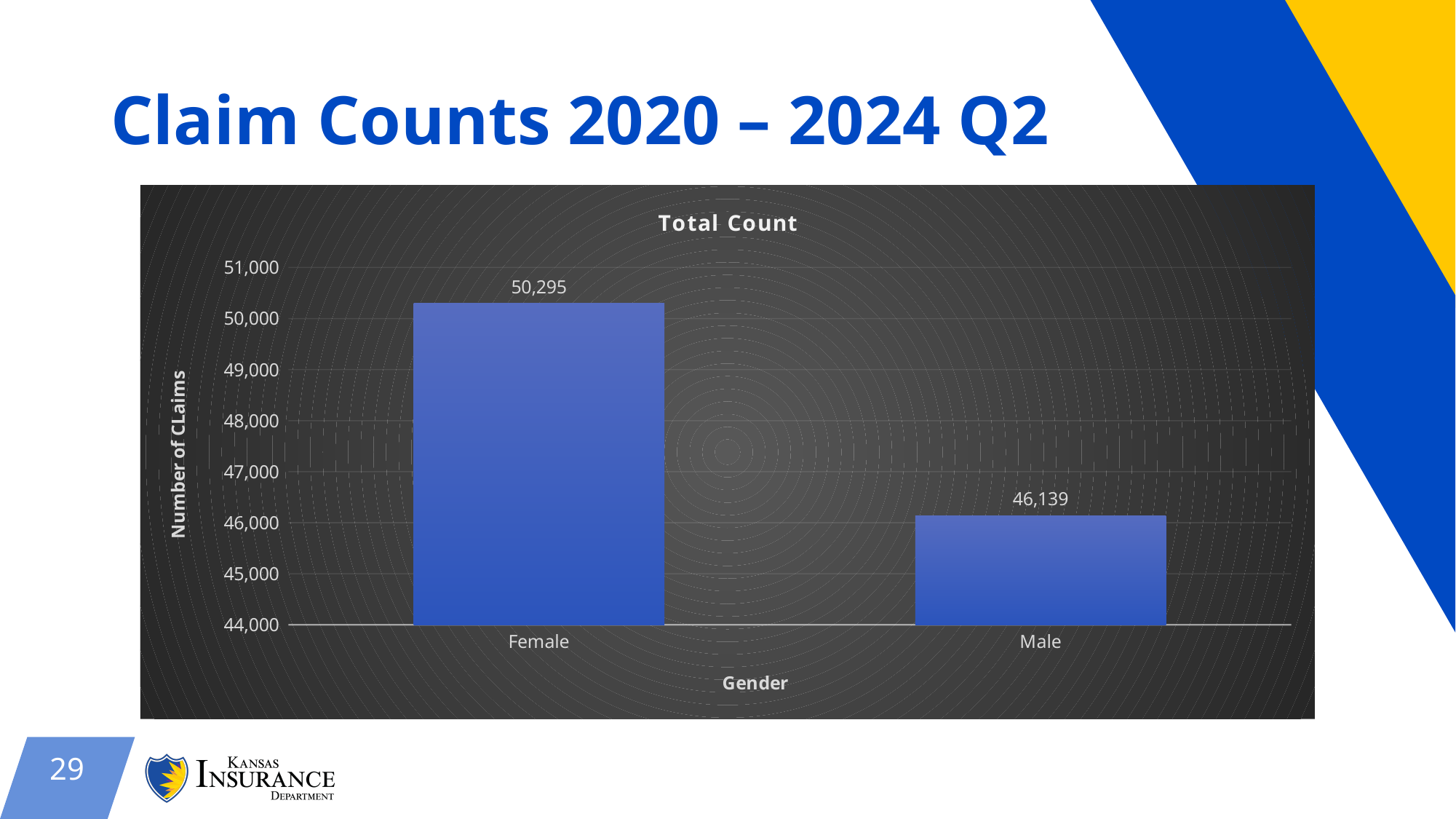
What is the total claim count for Female? 50,295 Which gender has the higher claim count? Female Is the claim count for Male greater or less than 47,000? less What is the combined claim count for Female and Male? 96,434 What is the difference between the Female and Male claim counts? 4,156 What is the title of the chart? Total Count Which gender has the lower claim count? Male Is the claim count for Female greater or less than 50,000? greater How many categories are shown on the x axis? 2 What is the label of the y axis? Number of CLaims What is the total claim count for Male? 46,139 What kind of chart is shown on the slide? bar chart